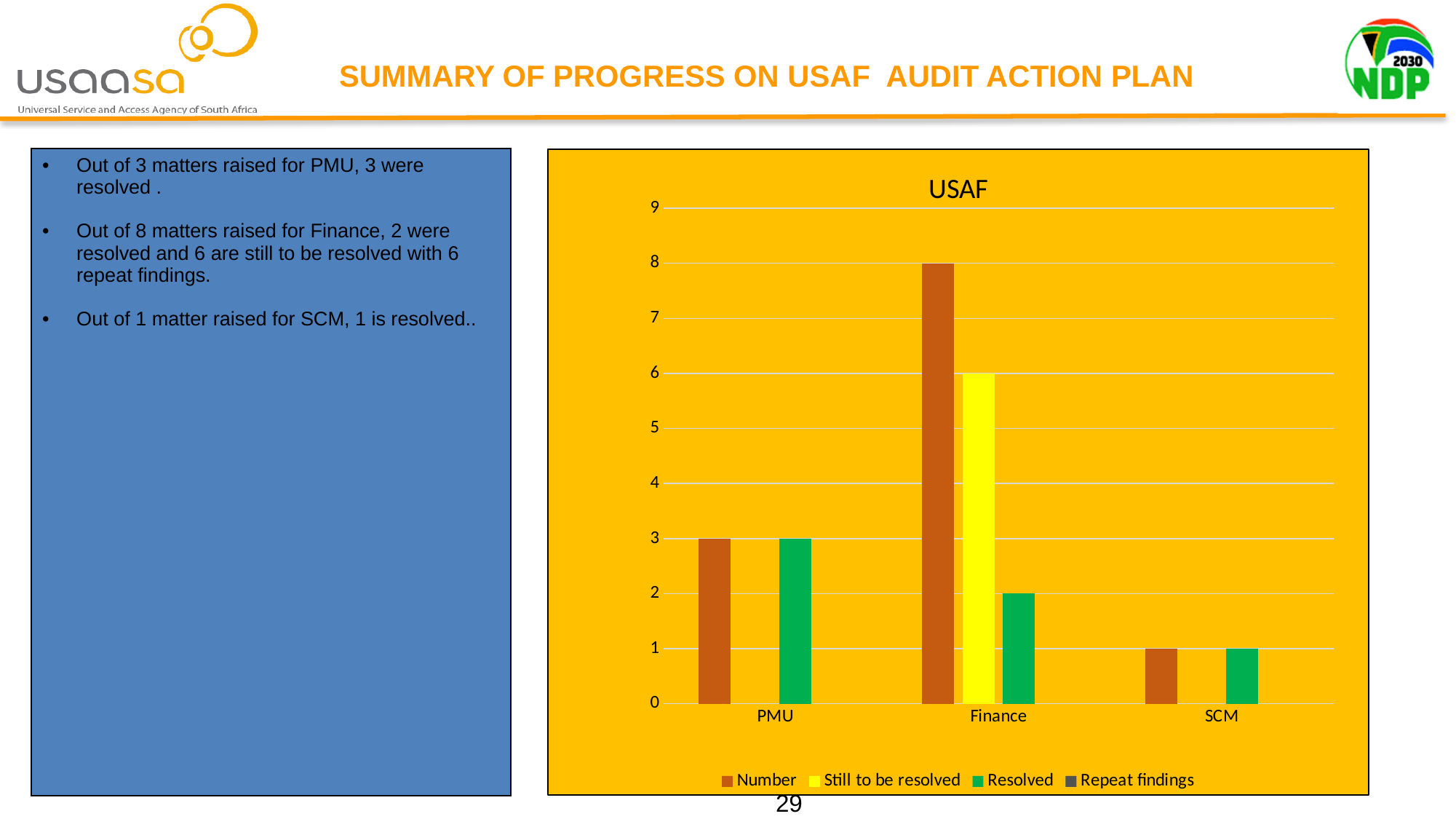
Which is larger for Finance: the Still to be resolved value or the Resolved value? Still to be resolved What kind of chart is shown on the slide? bar chart How many categories are shown on the x axis of the chart? 3 What is the value of the Number series for SCM? 1 What is the value of the Resolved series for PMU? 3 What is the title of the chart? USAF Which category has the lowest value for the Resolved series? SCM Which category has the highest value for the Number series? Finance What is the value of the Still to be resolved series for Finance? 6 What is the value of the Number series for Finance? 8 What is the difference between the Number and Resolved values for Finance? 6 How many series does the chart legend list? 4